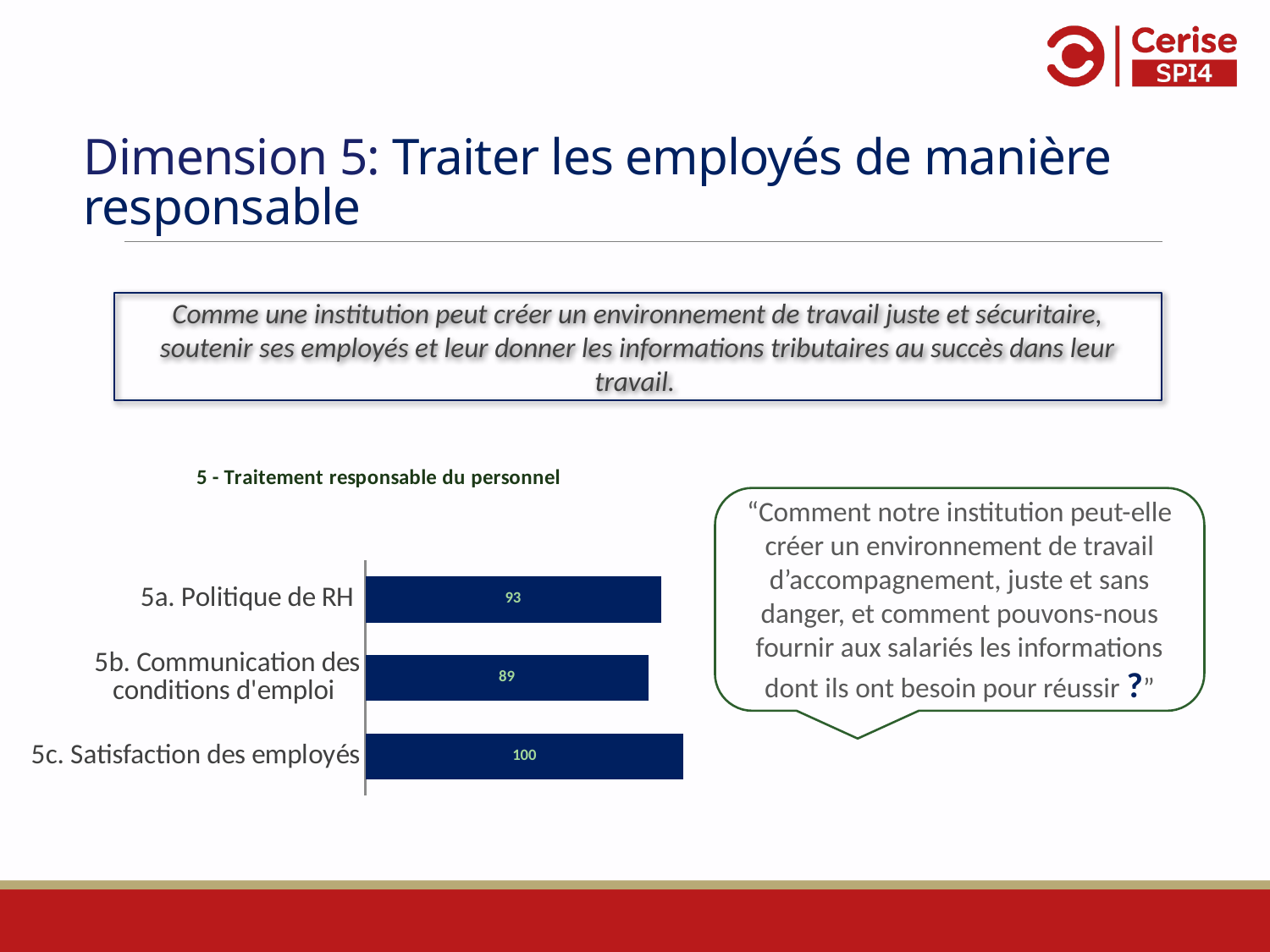
What is the title of the chart? 5 - Traitement responsable du personnel What kind of chart is shown on the slide? Bar chart Which is larger, the value for 5a. Politique de RH or the value for 5c. Satisfaction des employés? 5c. Satisfaction des employés What is the value for 5c. Satisfaction des employés? 100 How many categories are shown in the chart? 3 Which category has the lowest value? 5b. Communication des conditions d'emploi What colour are the bars in the chart? Dark blue What is the value for 5a. Politique de RH? 93 What is the value for 5b. Communication des conditions d'emploi? 89 Which category has the highest value? 5c. Satisfaction des employés What is the difference between the values for 5c. Satisfaction des employés and 5b. Communication des conditions d'emploi? 11 What is the difference between the values for 5a. Politique de RH and 5b. Communication des conditions d'emploi? 4